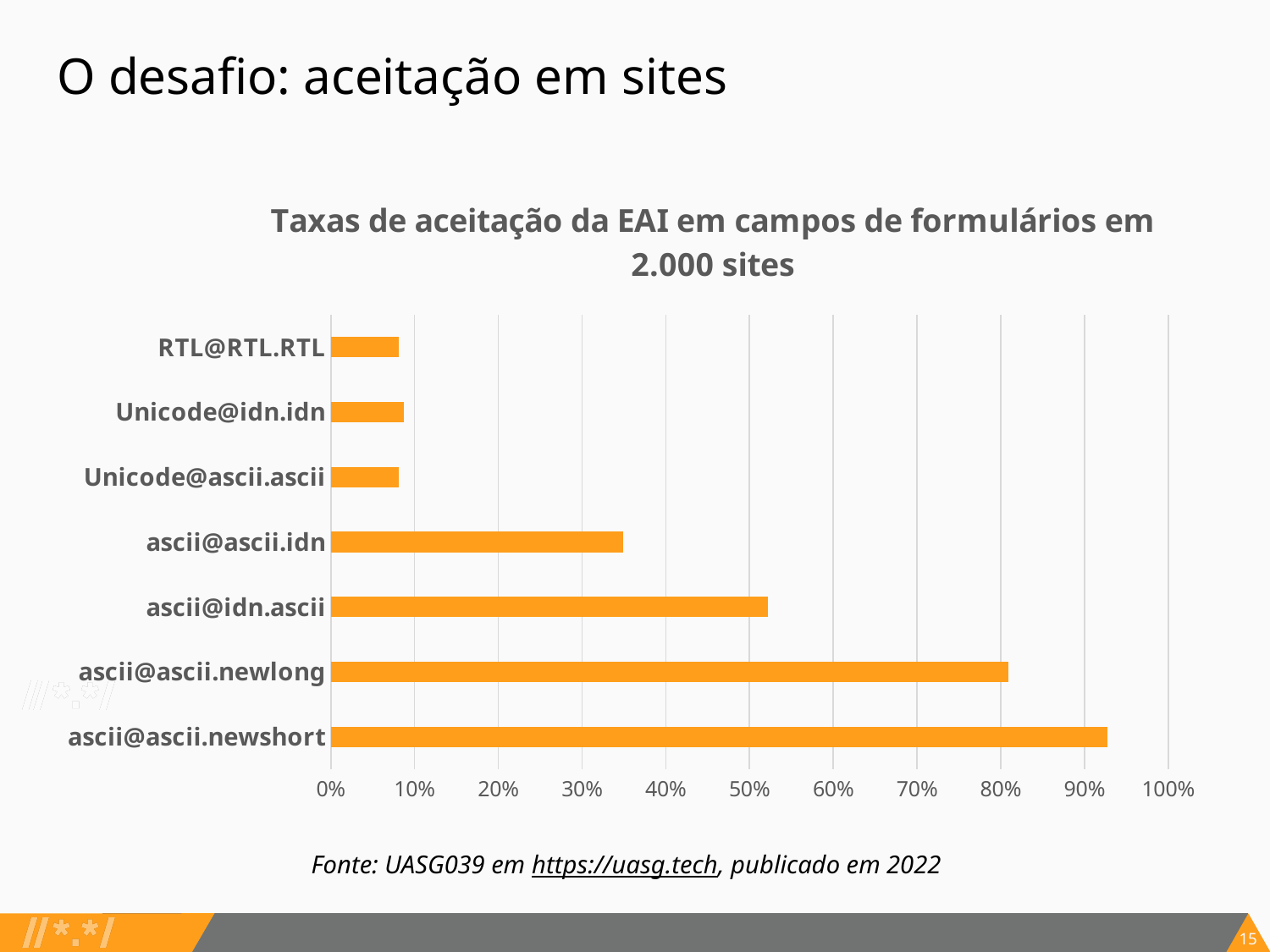
Is the value for Unicode@idn.idn greater or less than 20%? less Which is larger, the value for ascii@ascii.idn or the value for Unicode@ascii.ascii? ascii@ascii.idn Which is larger, the value for ascii@ascii.newlong or the value for ascii@idn.ascii? ascii@ascii.newlong Is the value for ascii@idn.ascii greater or less than 50%? greater What is the title of the chart? Taxas de aceitação da EAI em campos de formulários em 2.000 sites Is the value for ascii@ascii.newshort greater or less than 90%? greater How many categories are plotted in the chart? 7 Which category has the highest acceptance rate? ascii@ascii.newshort What kind of chart is shown on the slide? bar chart